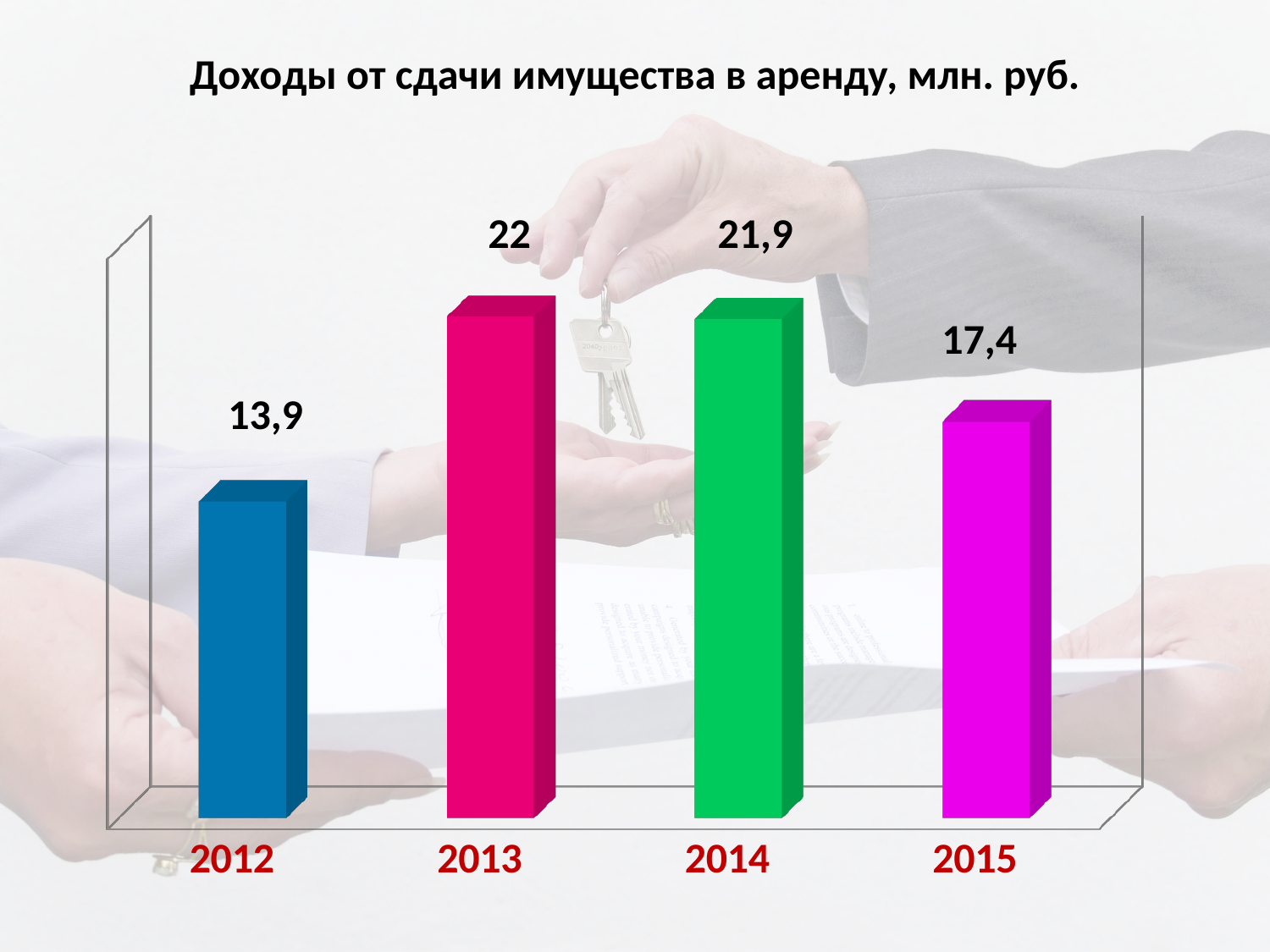
What is the value for 2015? 17,4 Which year has the lowest value? 2012 What is the difference between the values for 2014 and 2015? 4,5 What is the value for 2014? 21,9 Which year has the highest value? 2013 What is the title of the chart? Доходы от сдачи имущества в аренду, млн. руб. What is the value for 2013? 22 What is the value for 2012? 13,9 What kind of chart is shown on the slide? bar chart Which is larger, the value for 2012 or the value for 2015? 2015 What is the difference between the values for 2013 and 2012? 8,1 How many years are shown in the chart? 4